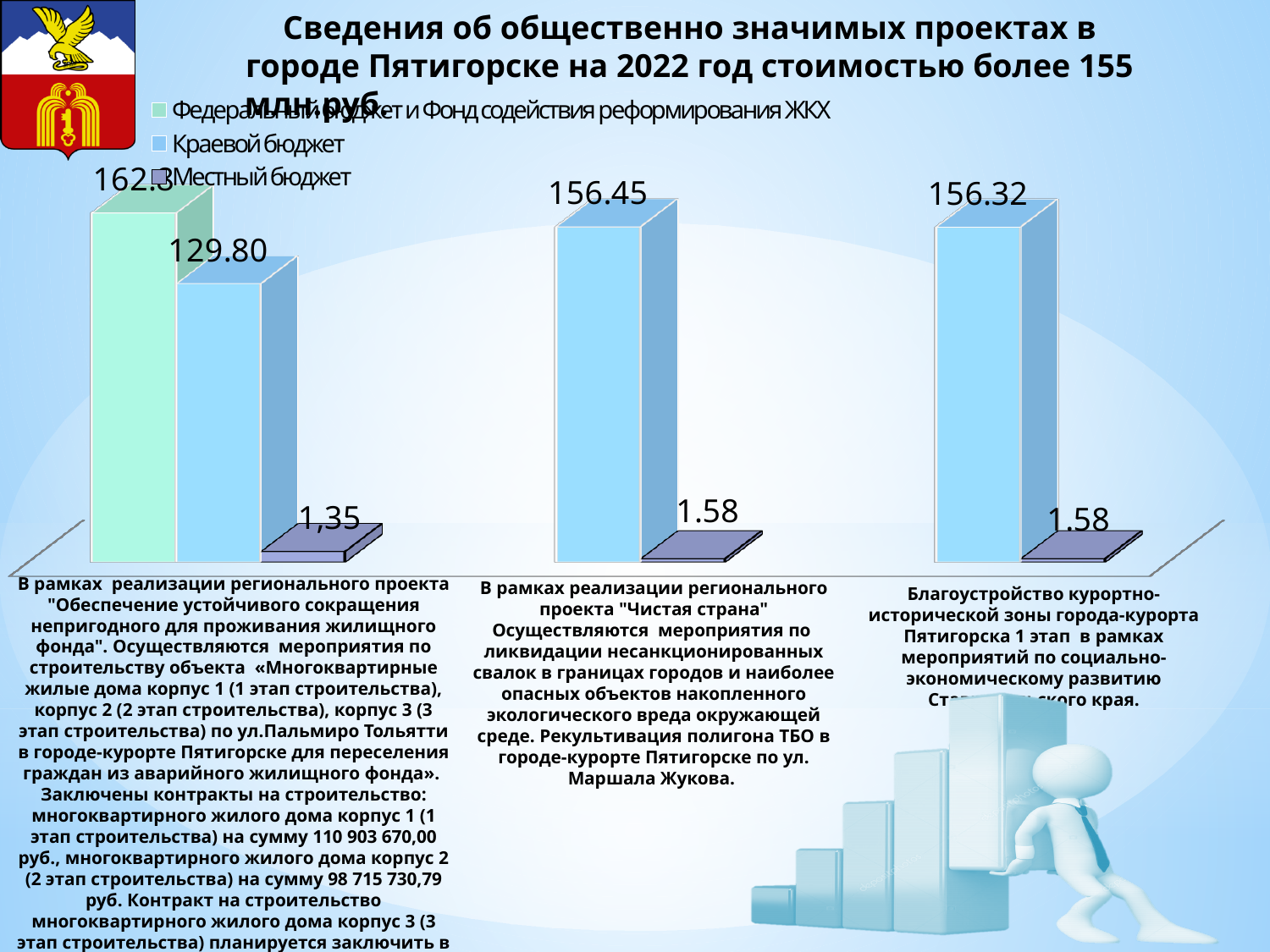
What is the value of Местный бюджет for the left group (project "Обеспечение устойчивого сокращения непригодного для проживания жилищного фонда")? 1,35 How many series does the legend list? 3 What is the value of Краевой бюджет for the left group (project "Обеспечение устойчивого сокращения непригодного для проживания жилищного фонда")? 129.80 What is the difference between the Краевой бюджет values for "Чистая страна" (156.45) and "Благоустройство курортно-исторической зоны" (156.32)? 0.13 Which legend entry is shown in light green? Федеральный бюджет и Фонд содействия реформирования ЖКХ Which project has the larger Краевой бюджет value: "Чистая страна" or "Благоустройство курортно-исторической зоны"? Чистая страна What is the value of Краевой бюджет for the project "Благоустройство курортно-исторической зоны города-курорта Пятигорска 1 этап" (right group)? 156.32 What is the value of Местный бюджет for the project "Чистая страна" (middle group)? 1.58 How many project groups (categories) are shown on the chart? 3 What is the value of Краевой бюджет for the project "Чистая страна" (middle group)? 156.45 Which project group has the lowest Краевой бюджет value? The left group ("Обеспечение устойчивого сокращения непригодного для проживания жилищного фонда") What kind of chart is shown on the slide? Bar chart